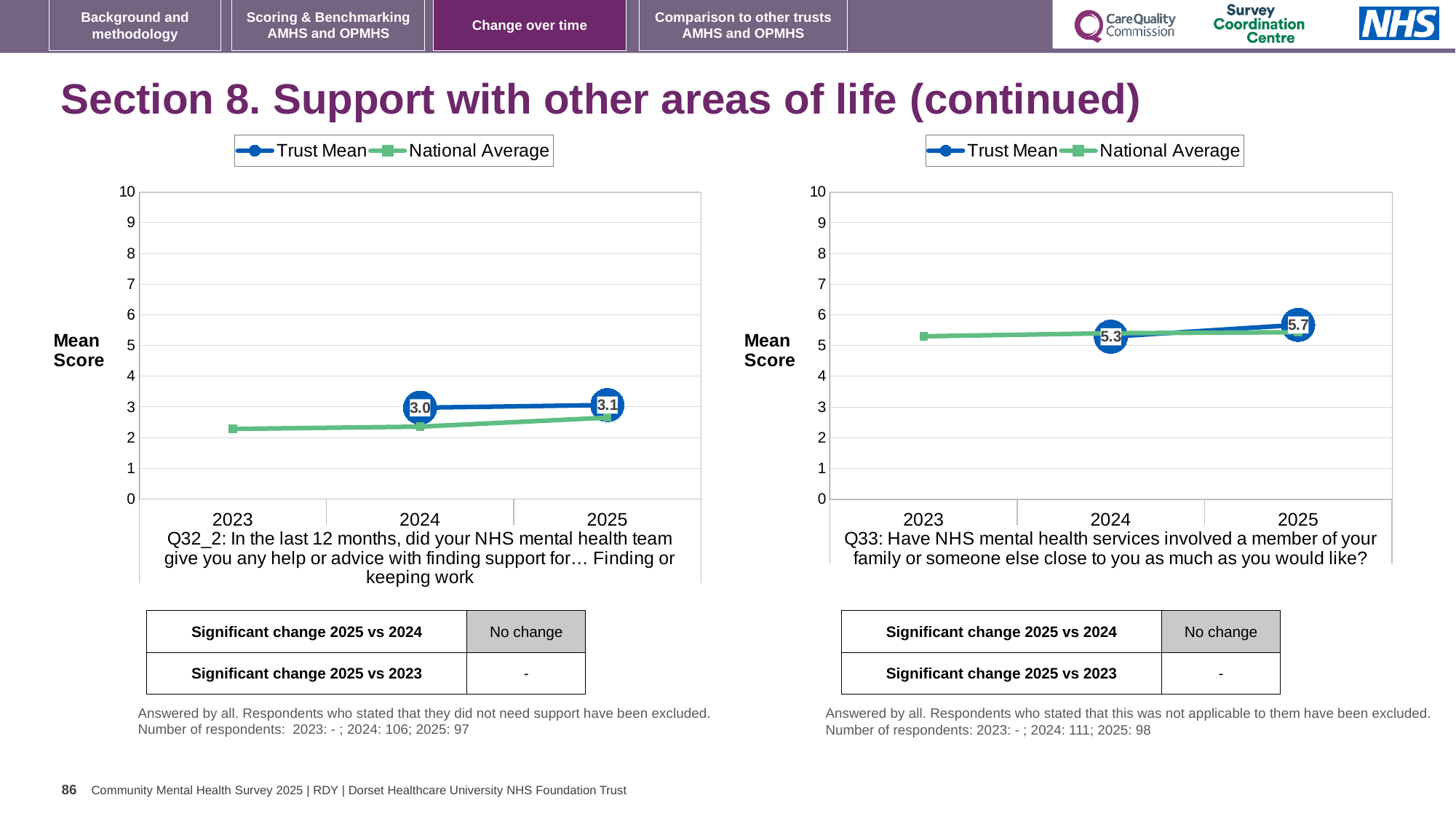
In the right chart (Q33), which series has the higher value in 2025, Trust Mean or National Average? Trust Mean In the left chart (Q32_2), what is the Trust Mean value for 2025? 3.1 What kind of chart is the left chart (Q32_2)? line chart How many series does the legend of the right chart (Q33) list? 2 How many years are shown on the x axis of the left chart (Q32_2)? 3 In the right chart (Q33), what is the Trust Mean value for 2025? 5.7 In the right chart (Q33), what is the Trust Mean value for 2024? 5.3 In the left chart (Q32_2), is the National Average value for 2023 greater or less than 3? less In the left chart (Q32_2), what is the Trust Mean value for 2024? 3.0 In the right chart (Q33), does the National Average rise or fall from 2023 to 2025? rise In the right chart (Q33), by how much did the Trust Mean change from 2024 to 2025? 0.4 In the left chart (Q32_2), does the Trust Mean rise or fall from 2024 to 2025? rise